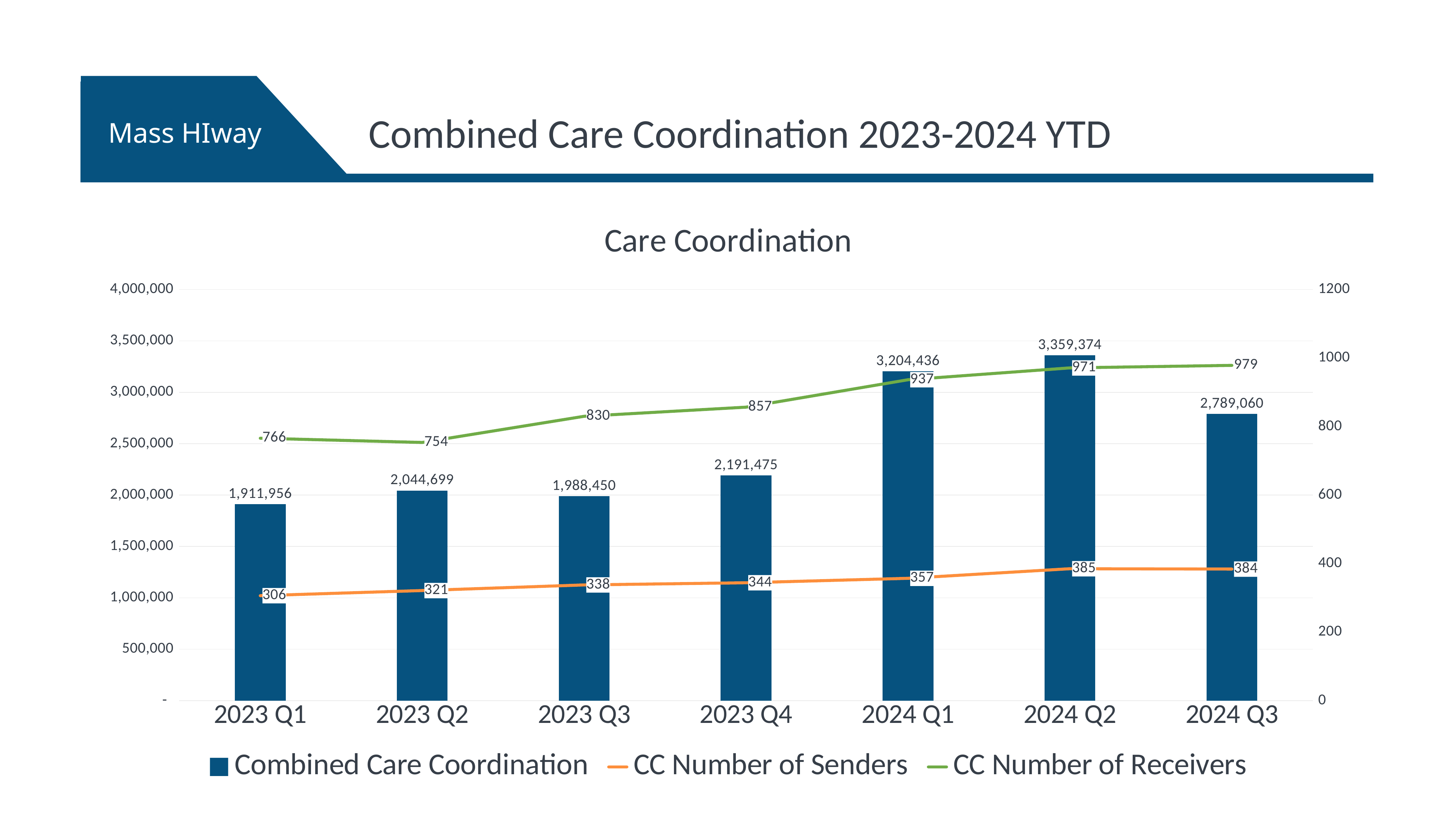
What kind of chart is used for the Combined Care Coordination series? Bar chart Which quarter has the highest Combined Care Coordination value? 2024 Q2 What is the CC Number of Receivers for 2024 Q3? 979 How many series does the legend list? 3 What is the difference in Combined Care Coordination between 2024 Q2 and 2024 Q3? 570,314 What is the CC Number of Senders for 2023 Q3? 338 Which is larger, the Combined Care Coordination value for 2023 Q2 or for 2023 Q3? 2023 Q2 Which quarter has the lowest CC Number of Receivers? 2023 Q2 What is the Combined Care Coordination value for 2024 Q2? 3,359,374 What is the title of the chart? Care Coordination How many quarters are shown on the x axis? 7 Does the CC Number of Senders rise or fall from 2023 Q1 to 2024 Q2? Rise